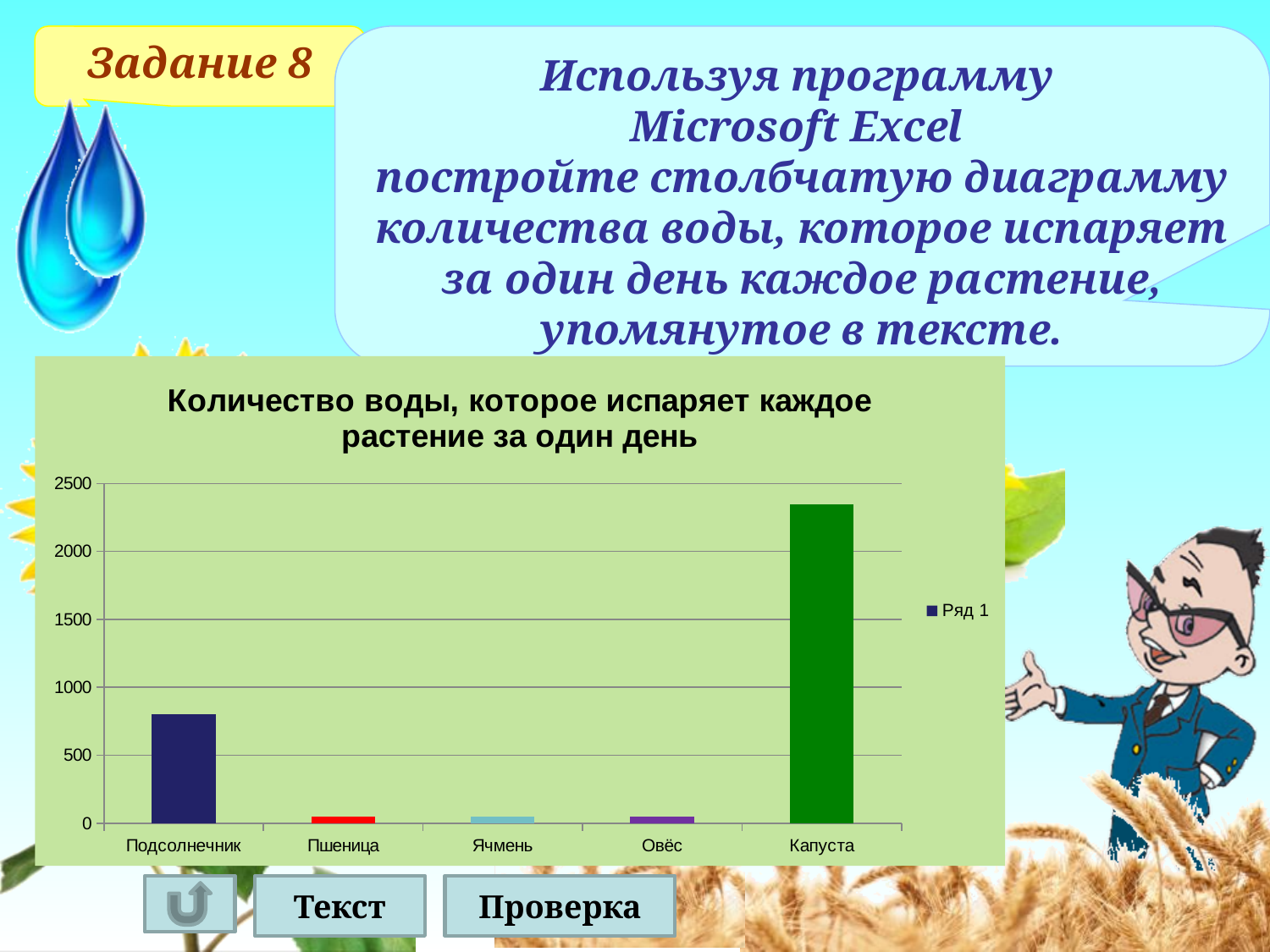
Is the value for Капуста greater or less than 2000? greater How many series does the chart legend list? 1 What is the title of the chart? Количество воды, которое испаряет каждое растение за один день Is the value for Подсолнечник greater or less than 500? greater How many plant categories are shown on the x axis of the chart? 5 Which plant has the highest bar in the chart? Капуста Is the value for Подсолнечник greater or less than 1000? less Which is larger, the value for Капуста or the value for Подсолнечник? Капуста What is the name of the series shown in the chart legend? Ряд 1 What kind of chart is shown on the slide? bar chart